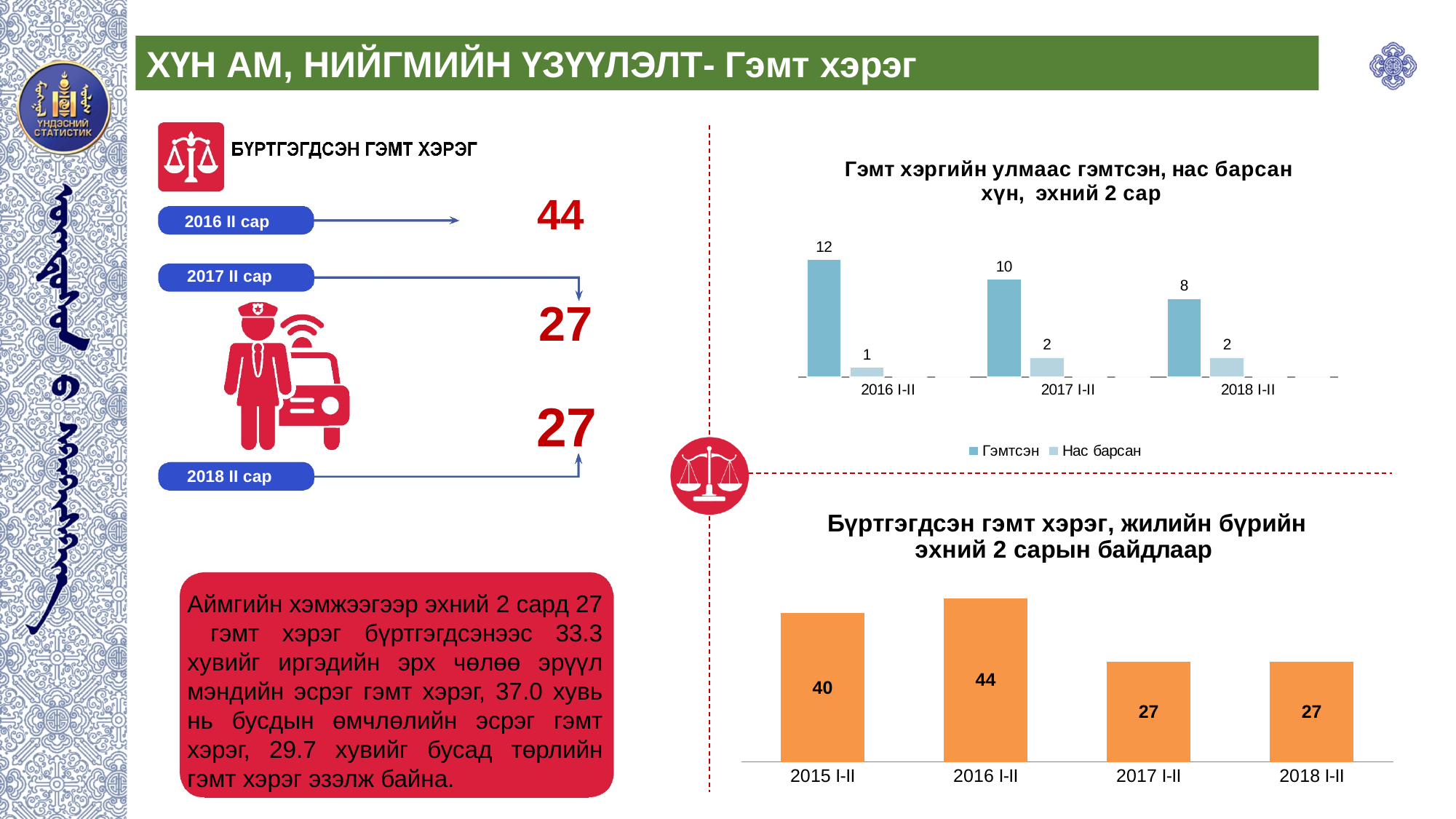
In the top-right chart (Гэмт хэргийн улмаас гэмтсэн, нас барсан хүн), does the Гэмтсэн value rise or fall from 2016 I-II to 2018 I-II? fall In the top-right chart (Гэмт хэргийн улмаас гэмтсэн, нас барсан хүн), how many series does the legend list? 2 What kind of chart is the bottom-right chart (Бүртгэгдсэн гэмт хэрэг)? bar chart In the bottom-right chart (Бүртгэгдсэн гэмт хэрэг), which year has the highest value? 2016 I-II In the bottom-right chart (Бүртгэгдсэн гэмт хэрэг), what is the difference between the values for 2016 I-II and 2017 I-II? 17 In the bottom-right chart (Бүртгэгдсэн гэмт хэрэг), how many categories are shown on the x axis? 4 In the top-right chart (Гэмт хэргийн улмаас гэмтсэн, нас барсан хүн), what is the value of Гэмтсэн for 2016 I-II? 12 In the bottom-right chart (Бүртгэгдсэн гэмт хэрэг), which is larger, the value for 2015 I-II or 2018 I-II? 2015 I-II In the bottom-right chart (Бүртгэгдсэн гэмт хэрэг), what is the value for 2015 I-II? 40 In the top-right chart (Гэмт хэргийн улмаас гэмтсэн, нас барсан хүн), what is the value of Нас барсан for 2017 I-II? 2 In the top-right chart (Гэмт хэргийн улмаас гэмтсэн, нас барсан хүн), which year has the lowest Гэмтсэн value? 2018 I-II In the top-right chart (Гэмт хэргийн улмаас гэмтсэн, нас барсан хүн), what is the difference between Гэмтсэн and Нас барсан in 2016 I-II? 11